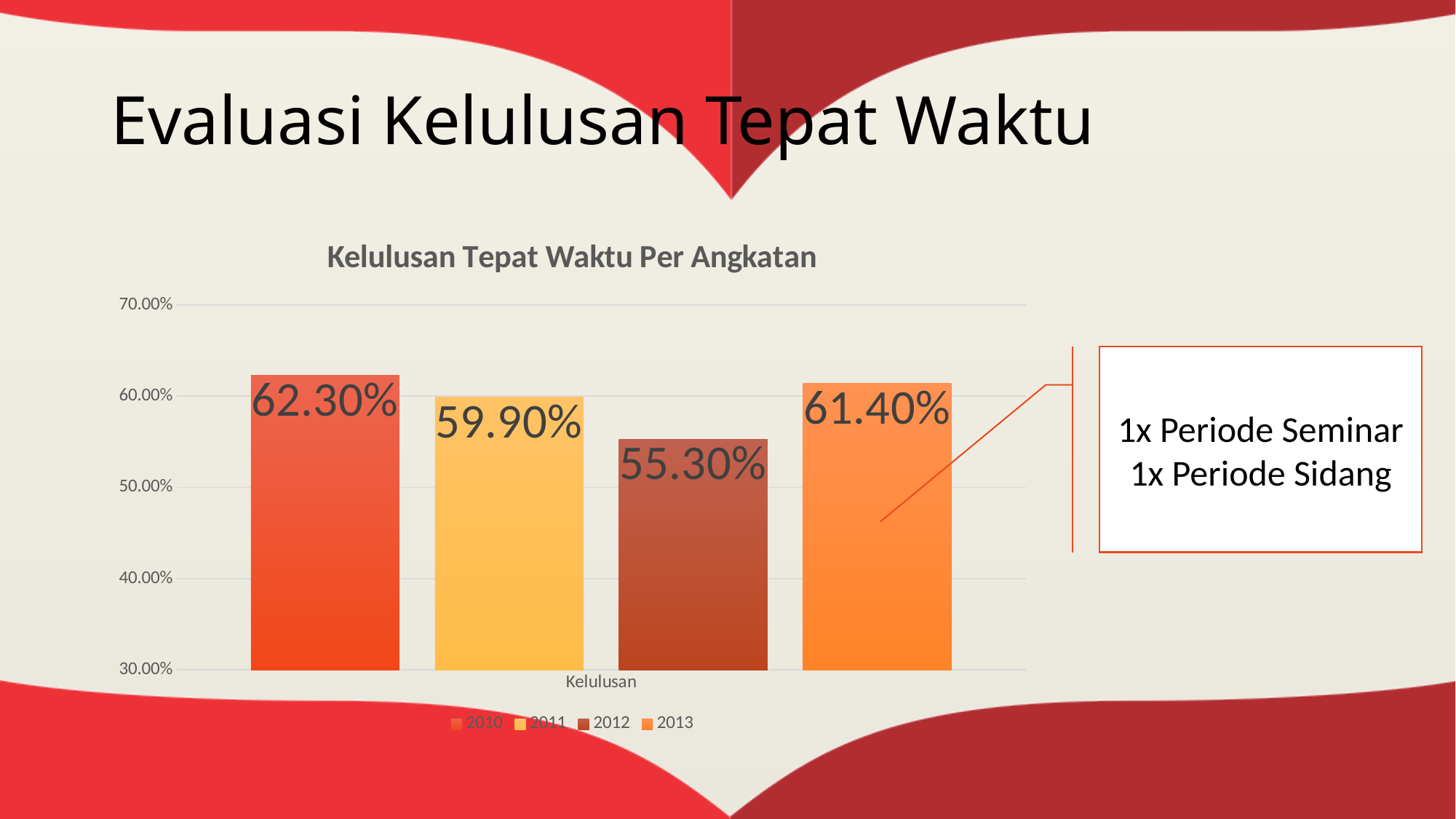
Is the value for 2012 greater or less than 60.00%? less Which is larger, the value for 2011 or the value for 2013? 2013 What is the value for 2011 in the chart? 59.90% Which year has the lowest on-time graduation rate? 2012 What is the difference between the values for 2010 and 2012? 7.00% What is the title of the chart? Kelulusan Tepat Waktu Per Angkatan Which year has the highest on-time graduation rate? 2010 What is the value for 2012 in the chart? 55.30% What is the value for 2010 in the chart? 62.30% How many series does the legend list? 4 What is the value for 2013 in the chart? 61.40% What kind of chart is shown on the slide? bar chart